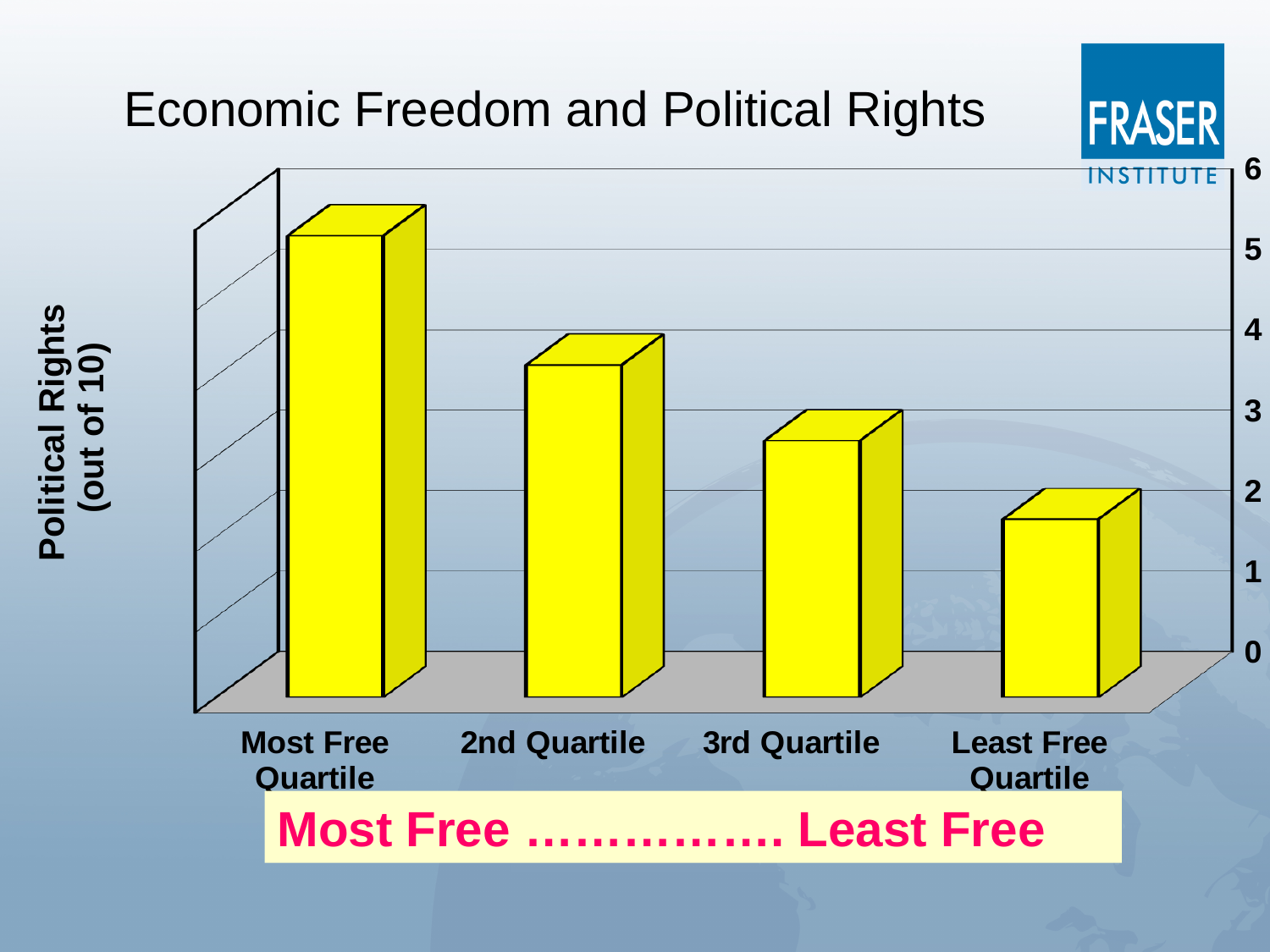
What kind of chart is shown on the slide? Bar chart Is the value for the 3rd Quartile greater or less than 2? greater Which quartile has the lowest political rights score? Least Free Quartile Which quartile has the highest political rights score? Most Free Quartile What is the title of the chart? Economic Freedom and Political Rights Is the value for the Most Free Quartile greater or less than 4? greater What is the label on the vertical axis of the chart? Political Rights (out of 10) Which has a higher political rights score, the 2nd Quartile or the 3rd Quartile? 2nd Quartile Do the political rights values rise or fall moving from the Most Free Quartile to the Least Free Quartile? Fall Is the value for the 2nd Quartile greater or less than 3? greater How many quartile categories are plotted on the chart? 4